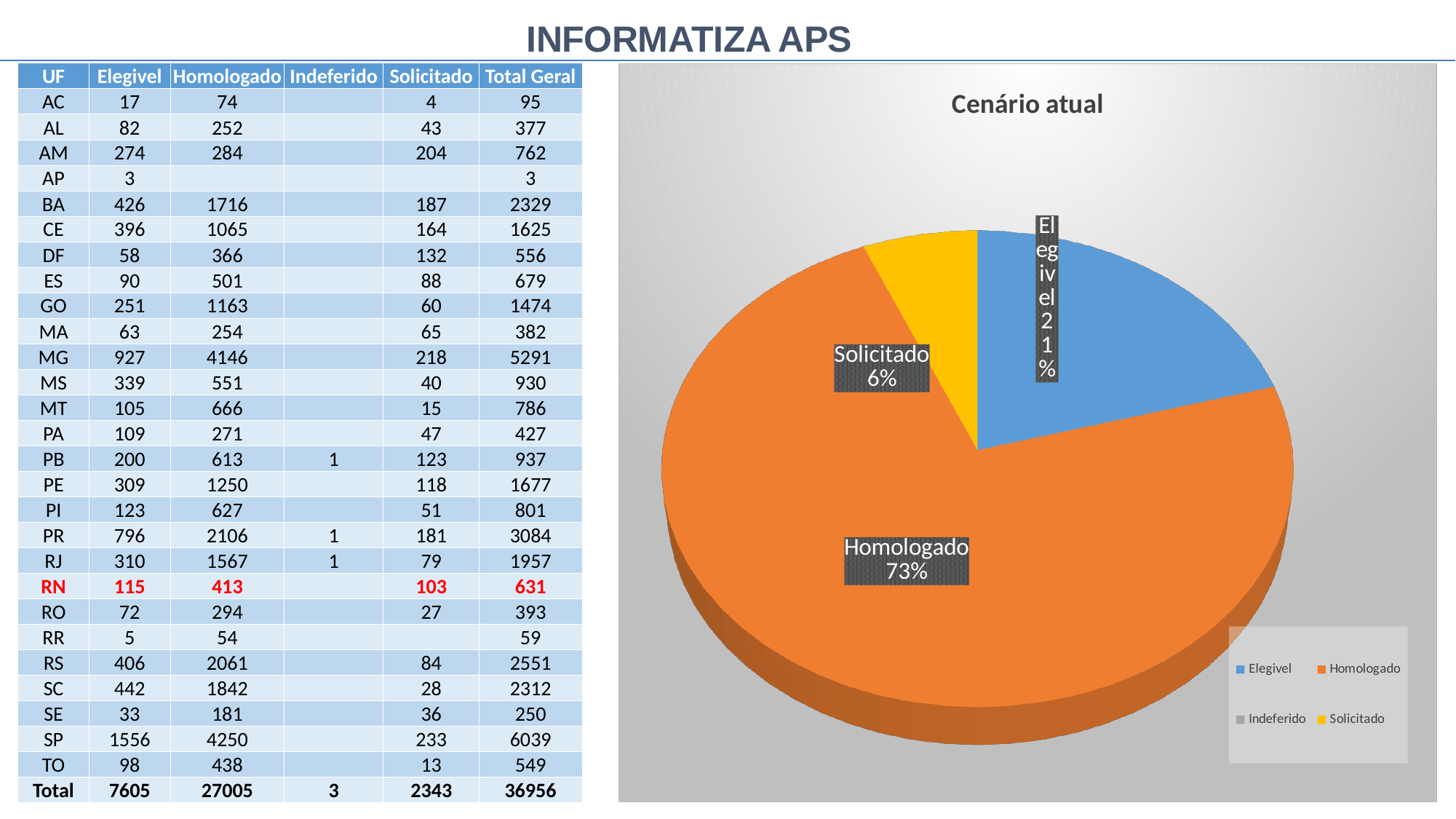
Which category has the largest slice in the pie chart? Homologado What colour is the Homologado slice in the pie chart? orange How many entries does the legend of the pie chart list? 4 In the pie chart, what share does Solicitado have? 6% What is the title of the pie chart? Cenário atual In the pie chart, what share does Homologado have? 73% Of the slices with a percentage label in the pie chart, which is the smallest? Solicitado In the pie chart, what share does Elegivel have? 21% In the pie chart, is the Homologado share greater or less than 50%? greater What kind of chart is shown on the right side of the slide? pie chart In the pie chart, which is larger: the Elegivel slice or the Solicitado slice? Elegivel In the pie chart, how many percentage points larger is Homologado's share than Elegivel's share? 52